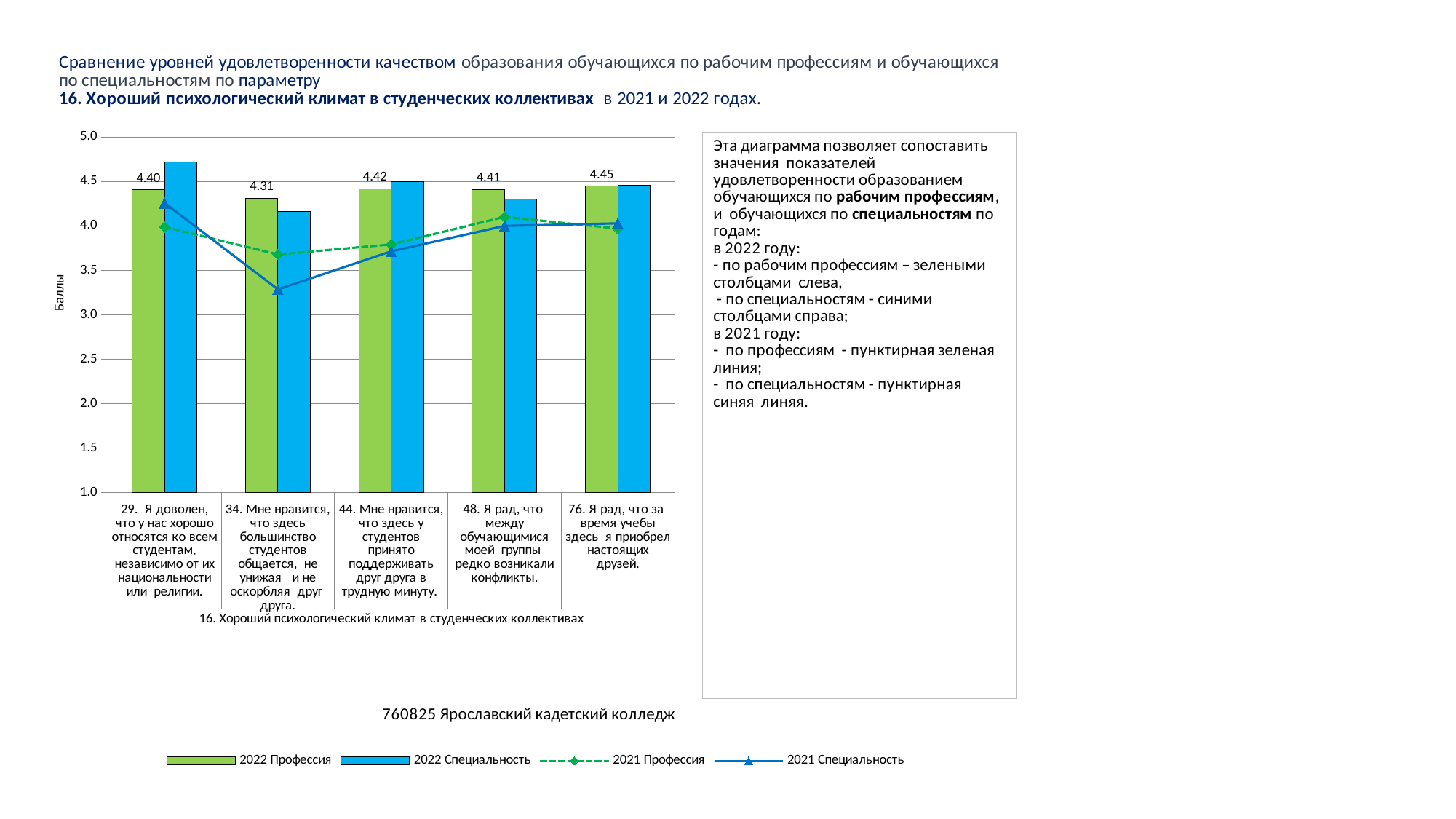
Which item has the highest 2022 Профессия value? 76. Я рад, что за время учебы здесь я приобрел настоящих друзей. Is the 2021 Специальность value for item 34 greater or less than 3.5? less How many survey items (categories) are shown on the x axis? 5 Is the 2022 Специальность value for item 29 greater or less than 4.5? greater What is the difference between the 2022 Профессия values for item 76 and item 34? 0.14 Which item has the lowest 2022 Профессия value? 34. Мне нравится, что здесь большинство студентов общается, не унижая и не оскорбляя друг друга. What is the label of the vertical axis? Баллы What is the 2022 Профессия value for item 29 (Я доволен, что у нас хорошо относятся ко всем студентам...)? 4.40 What is the 2022 Профессия value for item 34 (Мне нравится, что здесь большинство студентов общается, не унижая...)? 4.31 For item 29, which 2022 bar is taller: Профессия or Специальность? Специальность How many series does the legend list? 4 What is the 2022 Профессия value for item 76 (Я рад, что за время учебы здесь я приобрел настоящих друзей)? 4.45